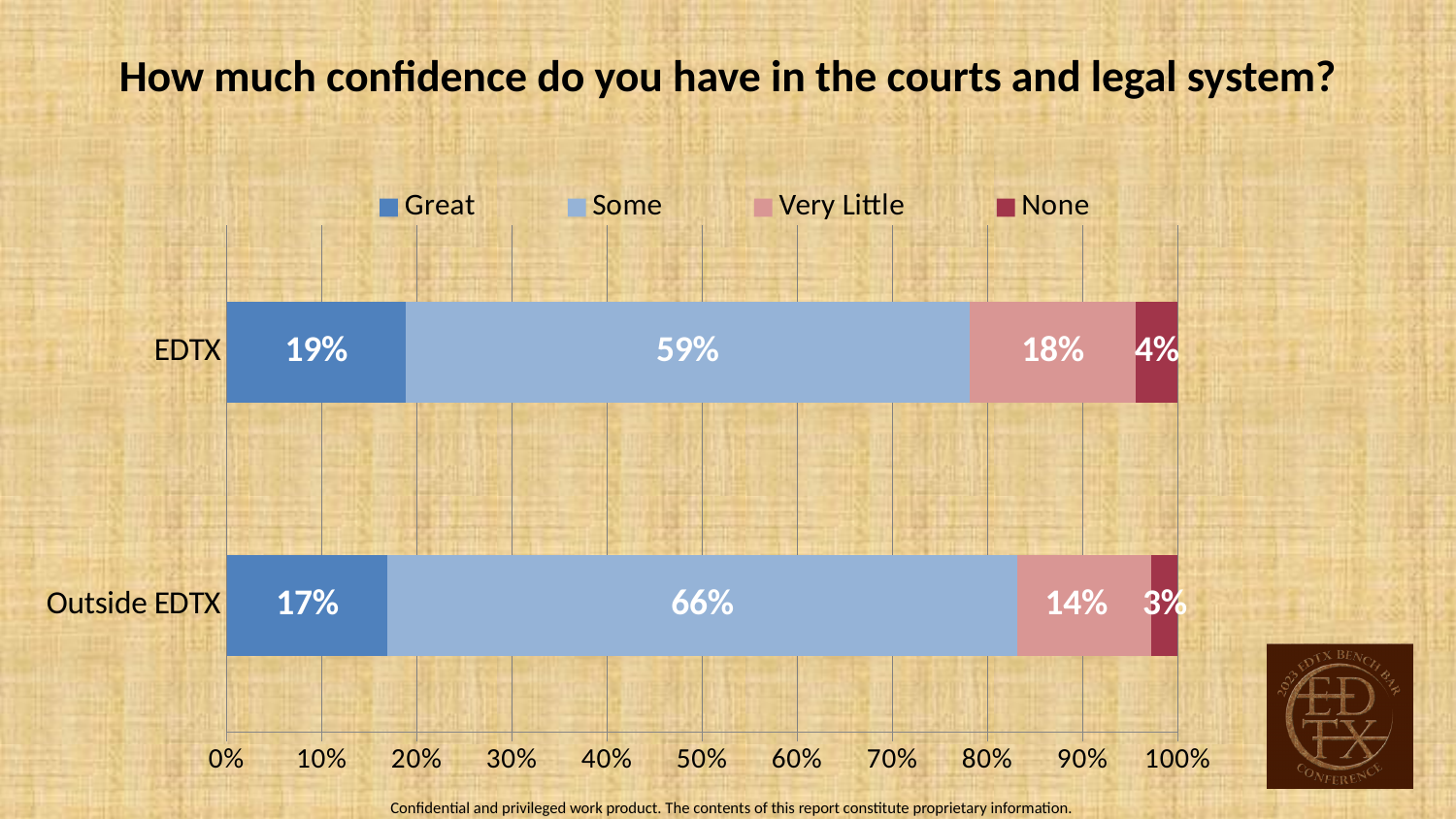
What percentage of Outside EDTX respondents have 'Great' confidence? 17% Which series has the largest value in the EDTX bar? Some How many series does the legend list? 4 How many categories are shown on the chart? 2 What is the difference between the 'Some' values for Outside EDTX and EDTX? 7% What is the 'None' value for EDTX? 4% What percentage of EDTX respondents have 'Some' confidence in the courts and legal system? 59% What is the 'Very Little' value for Outside EDTX? 14% What is the difference between the 'Very Little' values for EDTX and Outside EDTX? 4% Which series has the smallest value in the Outside EDTX bar? None What kind of chart is shown on the slide? Stacked bar chart Which category has the higher 'Some' value, EDTX or Outside EDTX? Outside EDTX